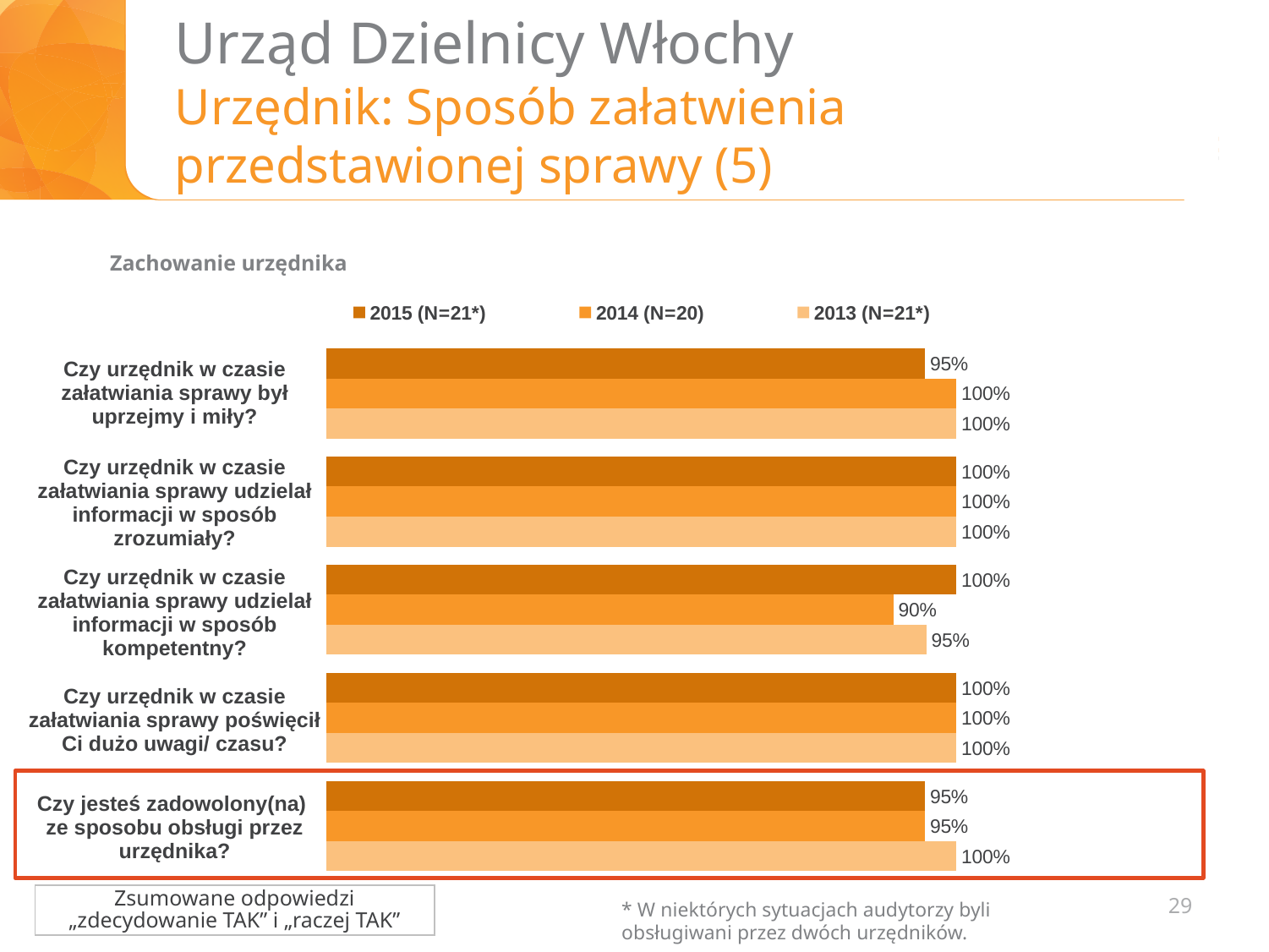
For "Czy urzędnik w czasie załatwiania sprawy był uprzejmy i miły?", which is larger: the 2015 value or the 2014 value? 2014 (N=20) How many series does the legend list? 3 What is the difference between the 2013 and 2015 values for "Czy jesteś zadowolony(na) ze sposobu obsługi przez urzędnika?"? 5% What is the 2015 (N=21*) value for "Czy urzędnik w czasie załatwiania sprawy poświęcił Ci dużo uwagi/ czasu?"? 100% How many question categories are plotted in the chart? 5 What is the 2013 (N=21*) value for "Czy jesteś zadowolony(na) ze sposobu obsługi przez urzędnika?"? 100% What is the title of the chart? Zachowanie urzędnika What is the 2014 (N=20) value for "Czy urzędnik w czasie załatwiania sprawy udzielał informacji w sposób kompetentny?"? 90% What is the difference between the 2015 and 2014 values for "Czy urzędnik w czasie załatwiania sprawy udzielał informacji w sposób kompetentny?"? 10% What is the 2015 (N=21*) value for "Czy urzędnik w czasie załatwiania sprawy był uprzejmy i miły?"? 95% What type of chart is shown on the slide? bar chart For "Czy urzędnik w czasie załatwiania sprawy udzielał informacji w sposób kompetentny?", which year has the lowest value? 2014 (N=20)